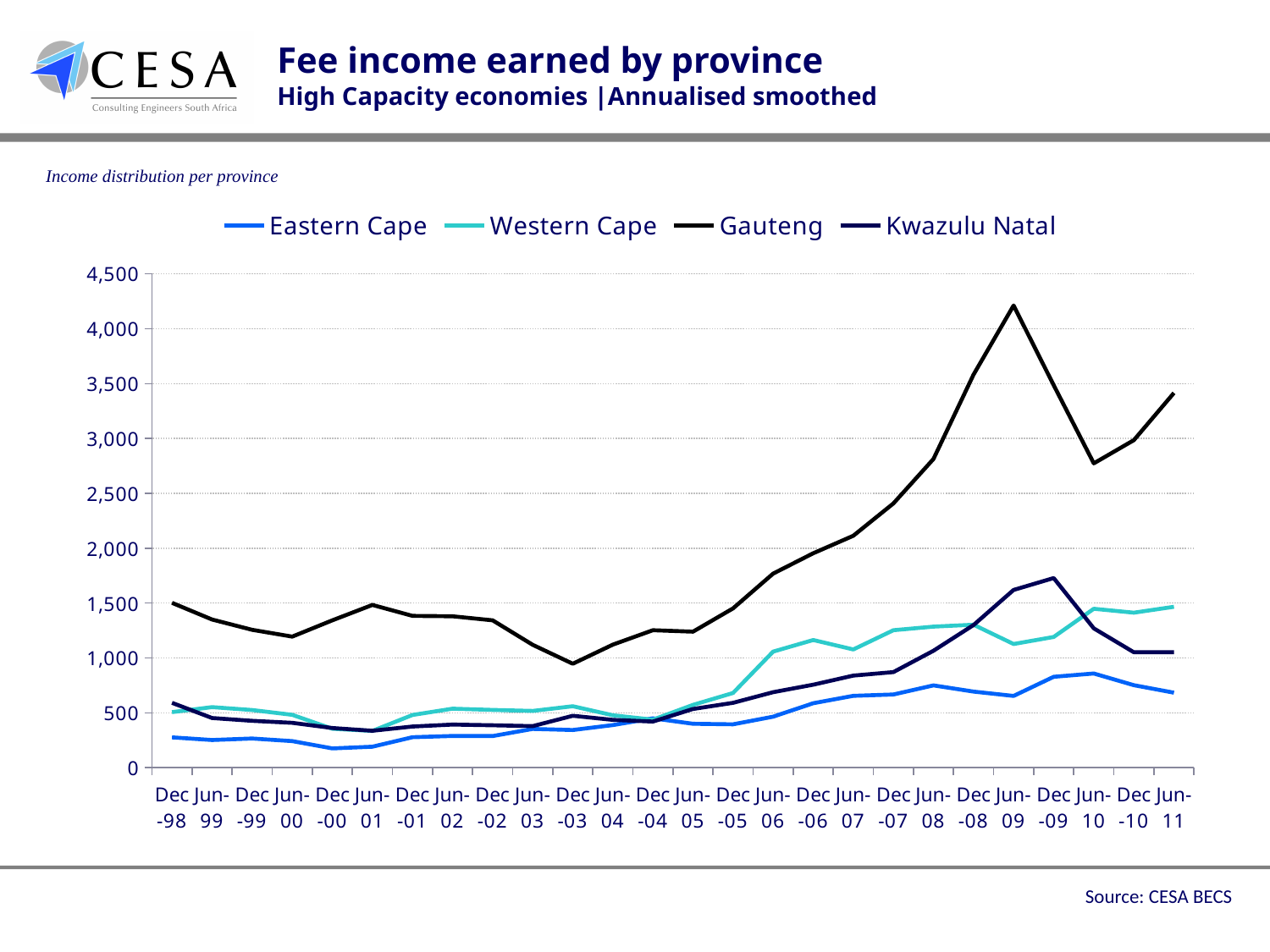
What kind of chart is shown on the slide? line chart How many time points are shown along the x axis? 26 Is the value for Eastern Cape at Dec-00 greater or less than 500? less Which colour is used for the Gauteng line? black Which province has the lowest fee income at Jun-09? Eastern Cape Does the Gauteng line rise or fall between Jun-09 and Jun-10? fall Which province has the highest fee income at Jun-09? Gauteng Is the value for Gauteng at Jun-09 greater or less than 4,000? greater Is the value for Gauteng at Dec-03 greater or less than 1,000? less At Jun-11, which is larger: Western Cape or Kwazulu Natal? Western Cape How many series does the legend list? 4